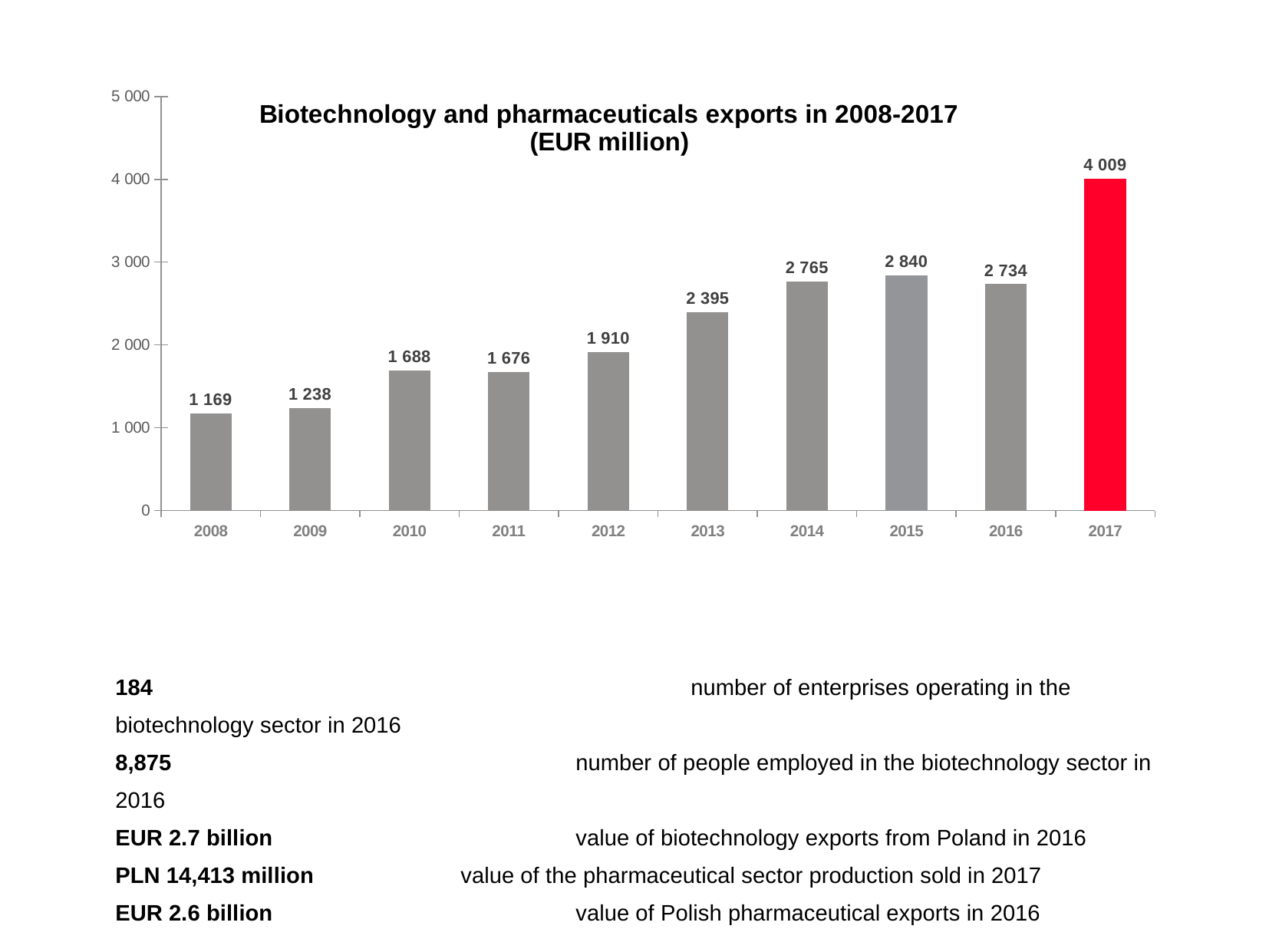
Which year has a larger export value, 2015 or 2016? 2015 Which year has the highest value of biotechnology and pharmaceuticals exports? 2017 What is the value of biotechnology and pharmaceuticals exports in 2017? 4 009 How many years are shown on the chart? 10 What is the difference between the export values for 2017 and 2016? 1 275 What kind of chart is used to show biotechnology and pharmaceuticals exports? bar chart Which bar on the chart is coloured red rather than grey? 2017 Is the export value for 2014 greater or less than 3 000? less What is the difference between the export values for 2009 and 2008? 69 What is the value of biotechnology and pharmaceuticals exports in 2008? 1 169 Which year has the lowest value of biotechnology and pharmaceuticals exports? 2008 What is the value of biotechnology and pharmaceuticals exports in 2013? 2 395